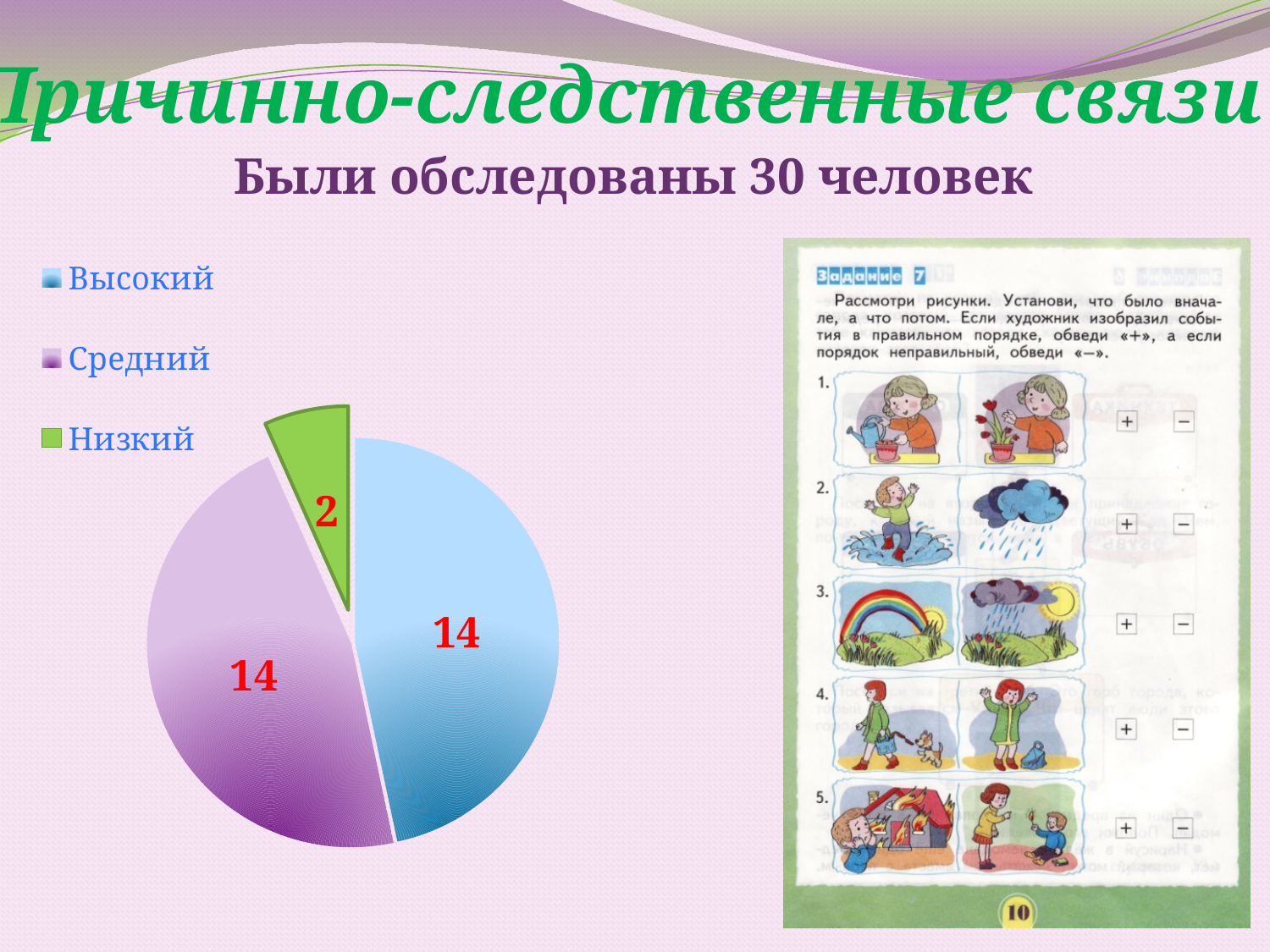
What colour is the Низкий slice in the pie chart? Green Which is larger, the value for Средний or the value for Низкий? Средний How many slices does the pie chart have? 3 How many entries does the legend of the pie chart list? 3 What value is shown for the Низкий slice of the pie chart? 2 What is the difference between the values for Высокий and Низкий? 12 What value is shown for the Высокий slice of the pie chart? 14 What is the total of all the values in the pie chart? 30 What value is shown for the Средний slice of the pie chart? 14 Which category has the smallest slice in the pie chart? Низкий What kind of chart is shown on the slide? Pie chart What fraction of the 30 surveyed people fall in the Низкий category? 2 out of 30